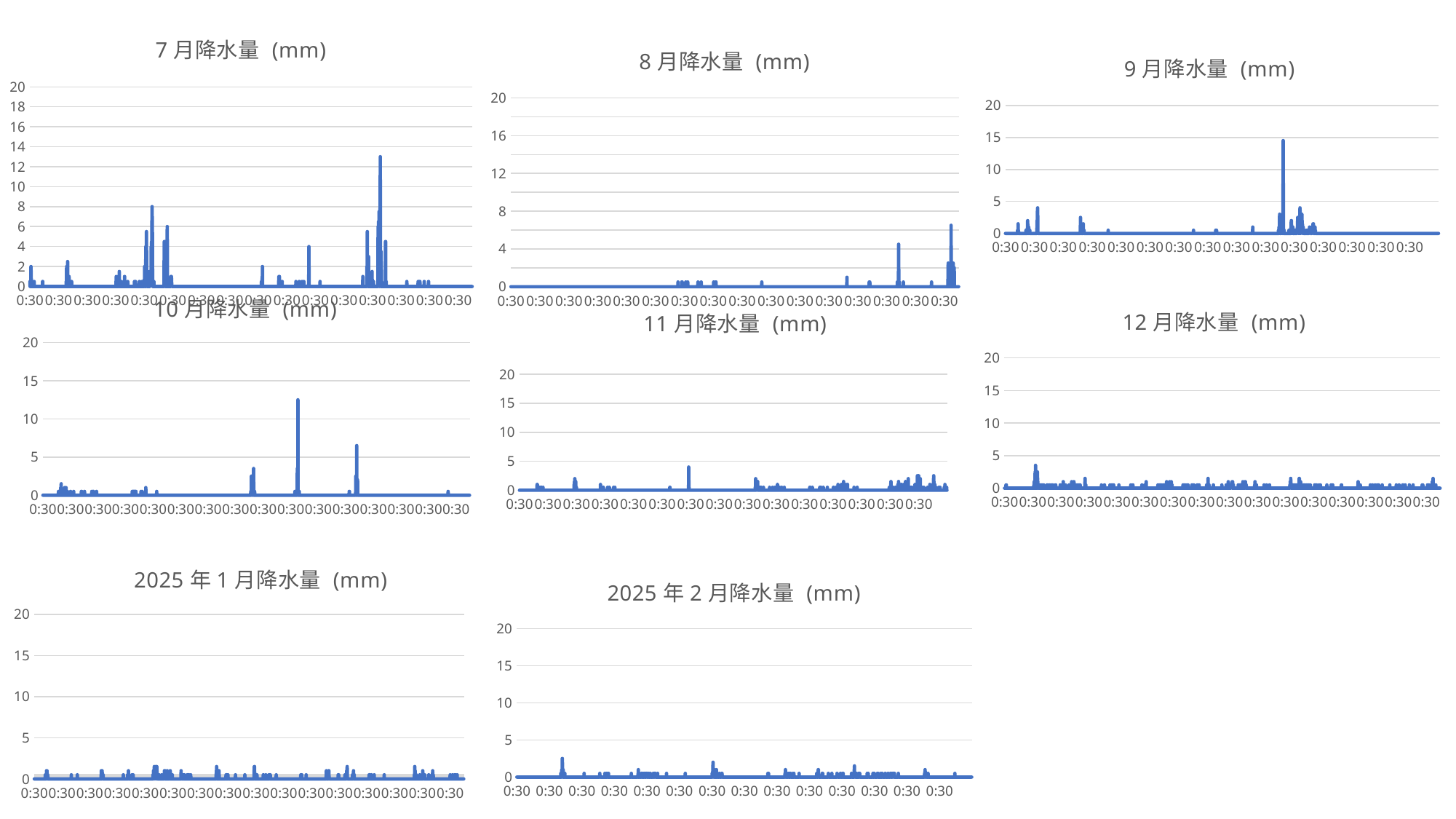
In the 10月降水量 (mm) chart, is the highest peak greater or less than 10? greater In the 2025年1月降水量 (mm) chart, is the highest value greater or less than 5? less In the 8月降水量 (mm) chart, is the highest peak greater or less than 8? less What kind of chart is the 7月降水量 (mm) chart? line chart What is the maximum value shown on the vertical axis of the 12月降水量 (mm) chart? 20 Which chart has the higher maximum peak, 7月降水量 (mm) or 8月降水量 (mm)? 7月降水量 (mm) What is the title of the chart in the top-left corner of the slide? 7月降水量 (mm) How many charts are shown on the slide? 8